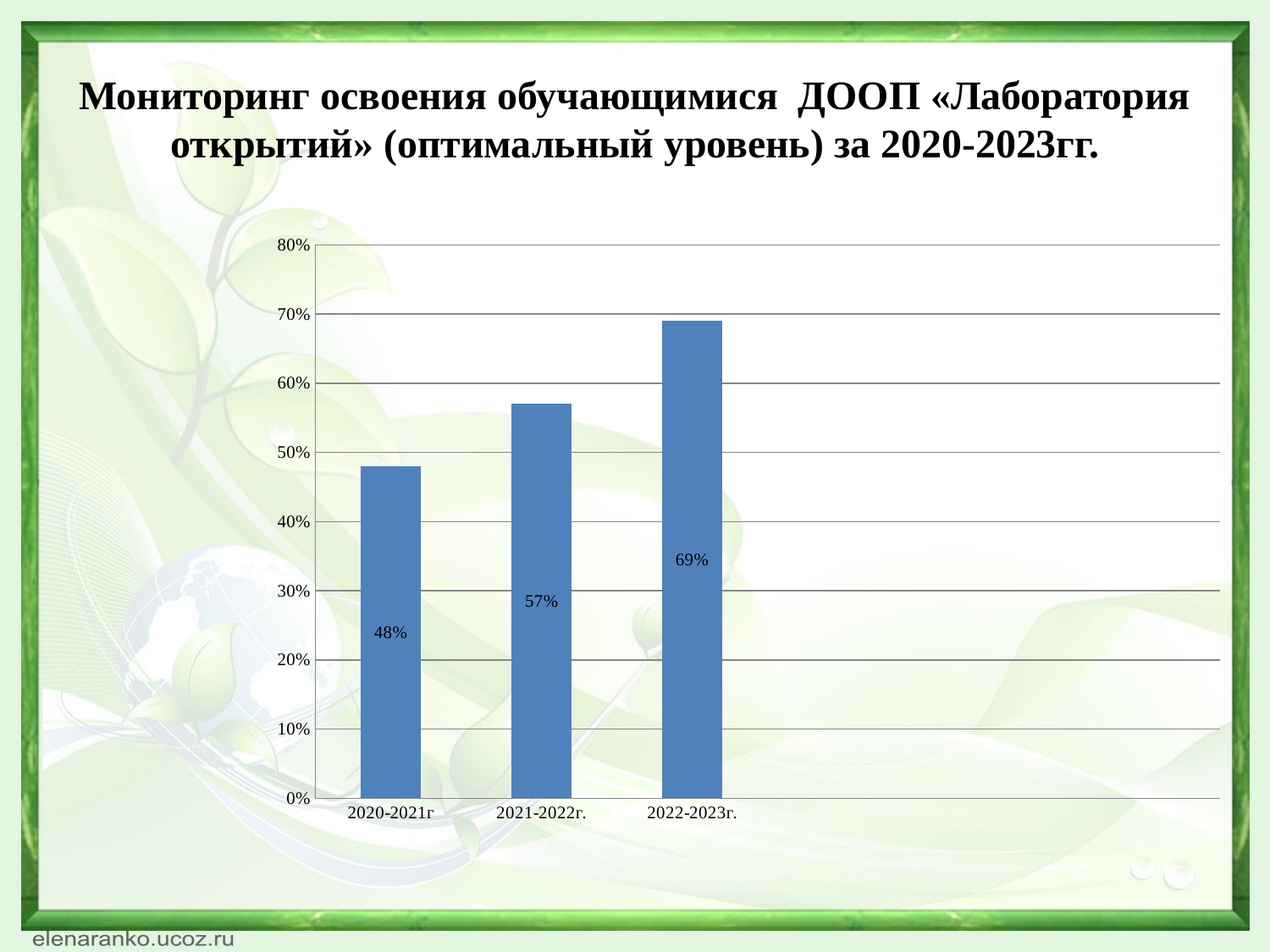
What is the difference between the values for 2022-2023г. and 2020-2021г? 21% Which category has the lowest value? 2020-2021г Is the value for 2022-2023г. greater or less than 60%? greater Do the values rise or fall from 2020-2021г to 2022-2023г.? rise What kind of chart is shown on the slide? bar chart Which category has the highest value? 2022-2023г. How many categories are shown on the x axis? 3 What is the value for 2020-2021г? 48% What is the value for 2021-2022г.? 57% What is the difference between the values for 2021-2022г. and 2020-2021г? 9% Which is larger, the value for 2021-2022г. or the value for 2022-2023г.? 2022-2023г. What is the value for 2022-2023г.? 69%